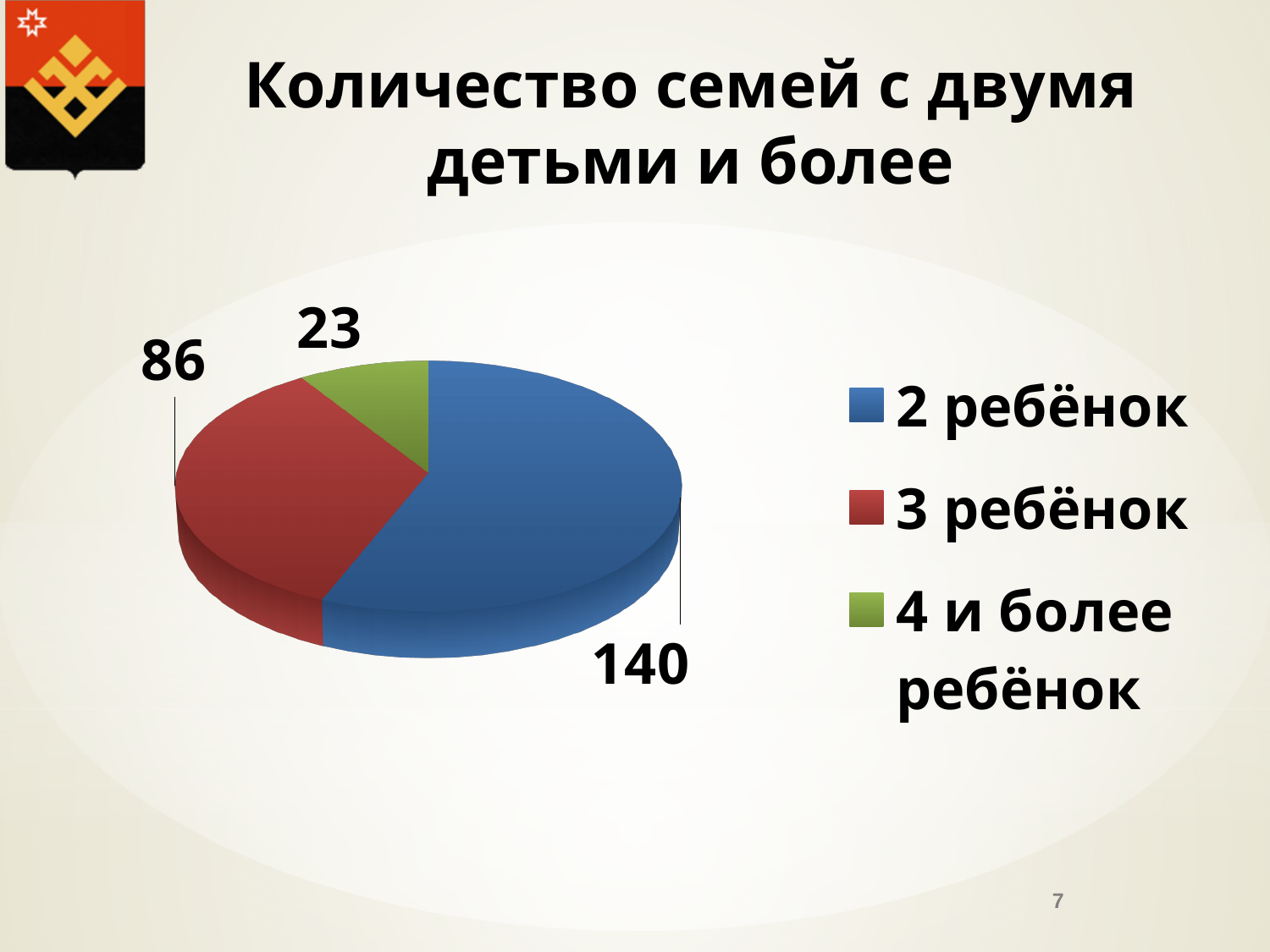
Which category has the smallest slice of the pie? 4 и более ребёнок What is the title of the chart on the slide? Количество семей с двумя детьми и более What is the value for the "4 и более ребёнок" slice? 23 What colour is the slice for "3 ребёнок"? Red Which is larger, the value for "3 ребёнок" or the value for "4 и более ребёнок"? 3 ребёнок What is the difference between the values for "3 ребёнок" and "4 и более ребёнок"? 63 How many slices does the pie chart have? 3 What is the value for the "3 ребёнок" slice? 86 What is the difference between the values for "2 ребёнок" and "3 ребёнок"? 54 What is the value for the "2 ребёнок" slice? 140 Which category has the largest slice of the pie? 2 ребёнок What kind of chart is shown on the slide? Pie chart